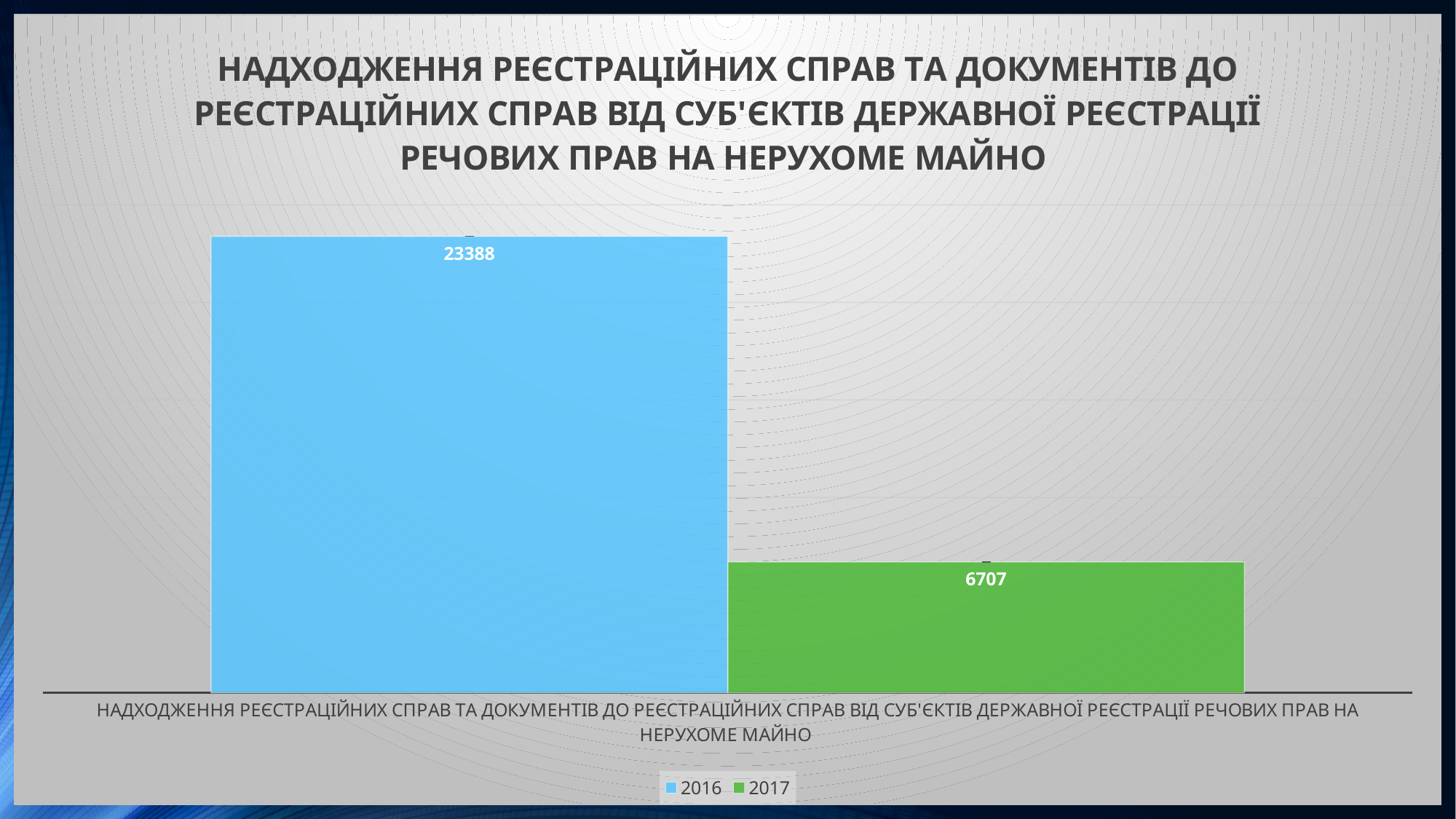
What colour is the bar for 2017? green How many bars are plotted on the chart? 2 What kind of chart is shown on the slide? bar chart What is the difference between the 2016 and 2017 values? 16681 What colour is the bar for 2016? blue Is the value for 2016 larger or smaller than the value for 2017? larger How many series does the legend list? 2 Which year has the lower value? 2017 What is the value for 2017? 6707 Which year has the higher value? 2016 What is the value for 2016? 23388 Do the values rise or fall from 2016 to 2017? fall